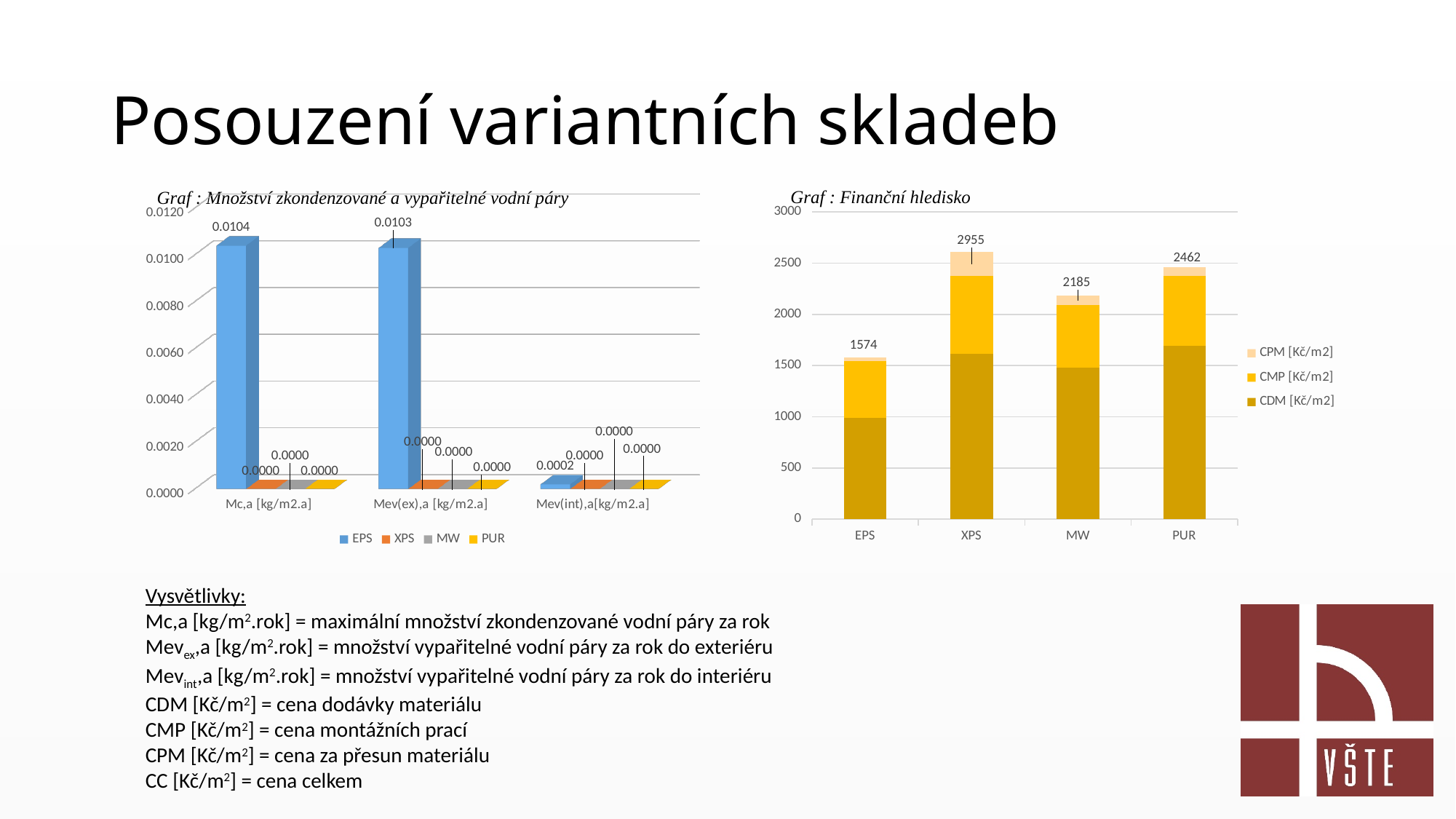
In the chart 'Graf : Finanční hledisko', which category has the lowest total? EPS In the chart 'Graf : Finanční hledisko', how many series does the legend list? 3 In the chart 'Graf : Množství zkondenzované a vypařitelné vodní páry', what is the EPS value for Mev(ex),a [kg/m2.a]? 0.0103 In the chart 'Graf : Finanční hledisko', what is the total for XPS? 2955 In the chart 'Graf : Množství zkondenzované a vypařitelné vodní páry', what is the EPS value for Mc,a [kg/m2.a]? 0.0104 In the chart 'Graf : Finanční hledisko', what is the total for EPS? 1574 In the chart 'Graf : Množství zkondenzované a vypařitelné vodní páry', what is the EPS value for Mev(int),a[kg/m2.a]? 0.0002 What kind of chart is 'Graf : Finanční hledisko'? Stacked bar chart In the chart 'Graf : Finanční hledisko', which total is larger, MW or PUR? PUR In the chart 'Graf : Množství zkondenzované a vypařitelné vodní páry', which series has the highest value for Mc,a [kg/m2.a]? EPS In the chart 'Graf : Množství zkondenzované a vypařitelné vodní páry', how many series does the legend list? 4 In the chart 'Graf : Finanční hledisko', what is the difference between the totals for XPS and EPS? 1381